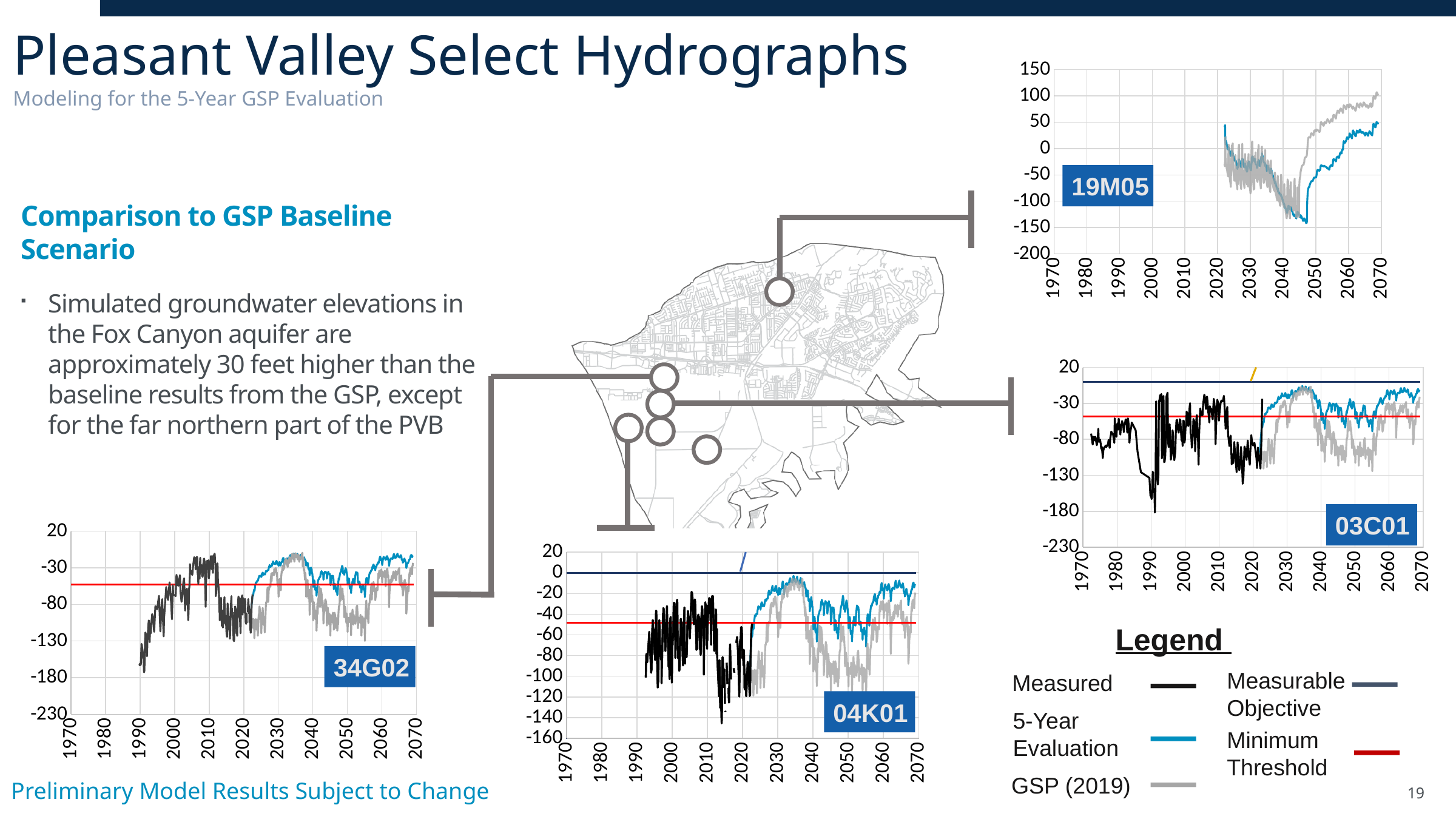
How many hydrograph charts are shown on the slide? 4 In the 04K01 chart, is the lowest Measured value (around 2015) greater or less than -120? less In the 19M05 chart, which series is higher at 2070, GSP (2019) (gray) or 5-Year Evaluation (blue)? GSP (2019) In the 19M05 chart, is the 5-Year Evaluation (blue) value at 2070 greater or less than 0? greater How many entries does the Legend list? 5 In the 19M05 chart, what is the highest value shown on the y axis? 150 In the 19M05 chart, does the 5-Year Evaluation (blue) line rise or fall between 2050 and 2070? rise Which of the four hydrograph charts has the highest maximum value on its y axis? 19M05 Which line colour does the Legend assign to the 5-Year Evaluation series? blue In the 03C01 chart, is the lowest Measured value (around 1992) greater or less than -130? less What kind of chart is the 19M05 hydrograph? line chart